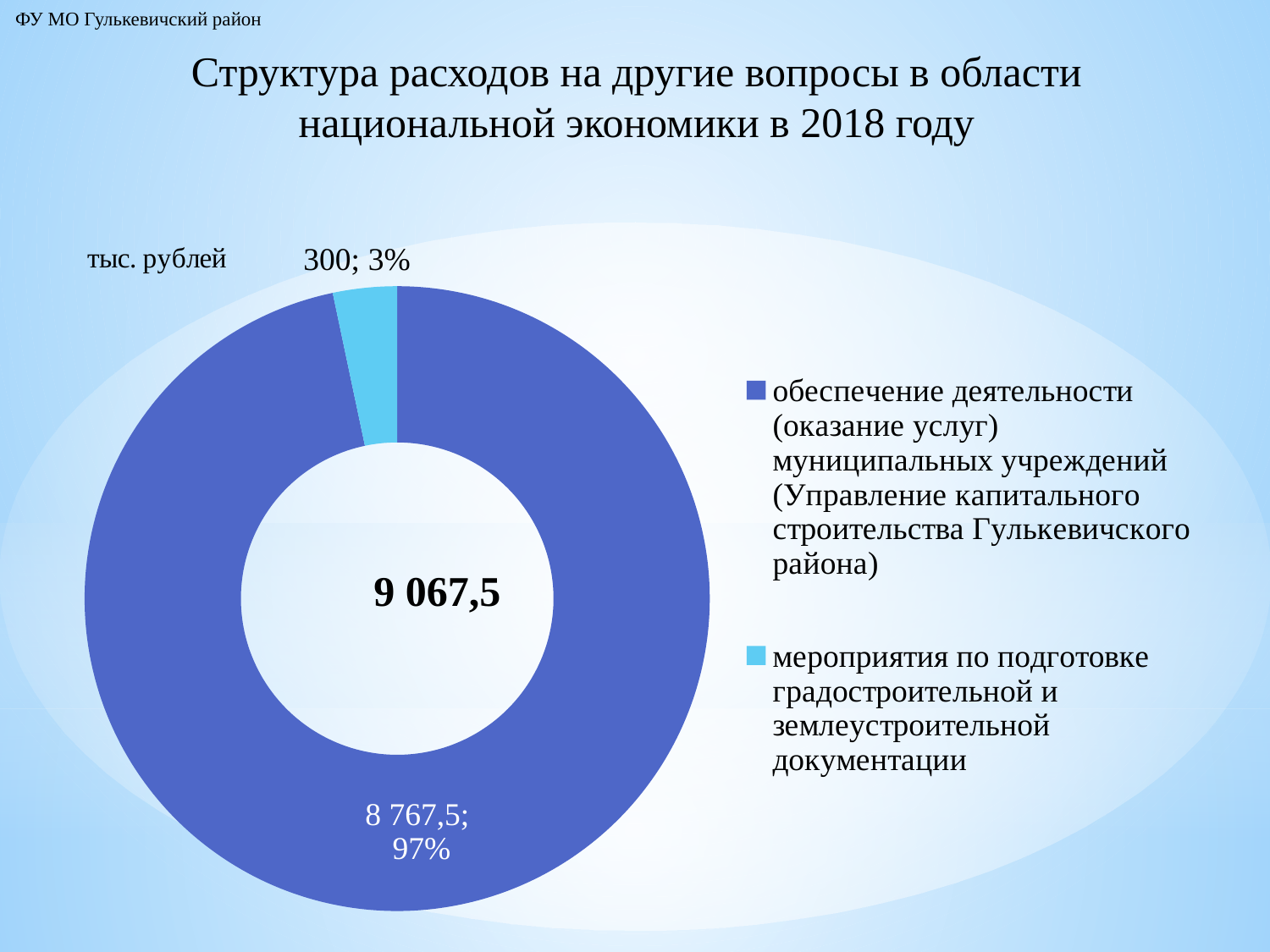
What total value is shown in the centre of the chart? 9 067,5 What unit is indicated for the chart values? тыс. рублей What is the value for 'обеспечение деятельности (оказание услуг) муниципальных учреждений (Управление капитального строительства Гулькевичского района)'? 8 767,5 Which category has the largest value? обеспечение деятельности (оказание услуг) муниципальных учреждений (Управление капитального строительства Гулькевичского района) What share of the chart does 'мероприятия по подготовке градостроительной и землеустроительной документации' represent? 3% What share of the chart does 'обеспечение деятельности (оказание услуг) муниципальных учреждений' represent? 97% What kind of chart is shown on the slide? Doughnut (pie) chart Which category has the smallest value? мероприятия по подготовке градостроительной и землеустроительной документации What colour is the slice for 'мероприятия по подготовке градостроительной и землеустроительной документации'? Light blue How many categories does the chart show? 2 What is the difference between the values for 'обеспечение деятельности' and 'мероприятия по подготовке градостроительной и землеустроительной документации'? 8 467,5 What is the value for 'мероприятия по подготовке градостроительной и землеустроительной документации'? 300